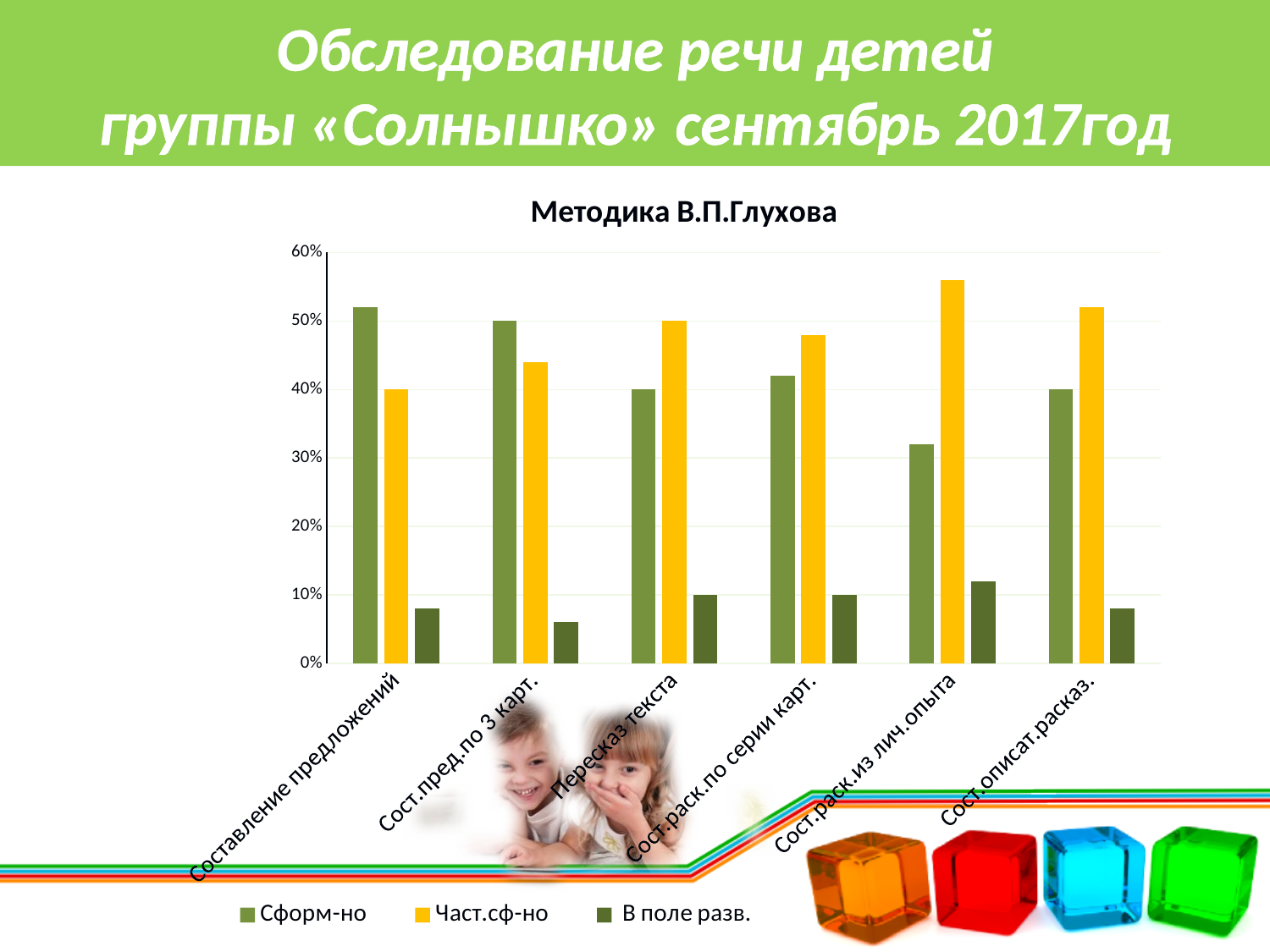
Is the value of "В поле разв." for "Сост.пред.по 3 карт." greater or less than 10%? less For "Составление предложений", which series has the larger value: "Сформ-но" or "Част.сф-но"? Сформ-но How many categories are shown on the x axis? 6 What kind of chart is shown on the slide? bar chart Is the value of "Сформ-но" for "Составление предложений" greater or less than 40%? greater Is the value of "Част.сф-но" for "Сост.раск.из лич.опыта" greater or less than 50%? greater Which category has the highest value for the series "Част.сф-но"? Сост.раск.из лич.опыта What is the title of the chart? Методика В.П.Глухова How many series does the legend list? 3 What is the value of "Част.сф-но" for "Пересказ текста"? 50% Which category has the lowest value for the series "Сформ-но"? Сост.раск.из лич.опыта What is the value of "Сформ-но" for "Сост.пред.по 3 карт."? 50%